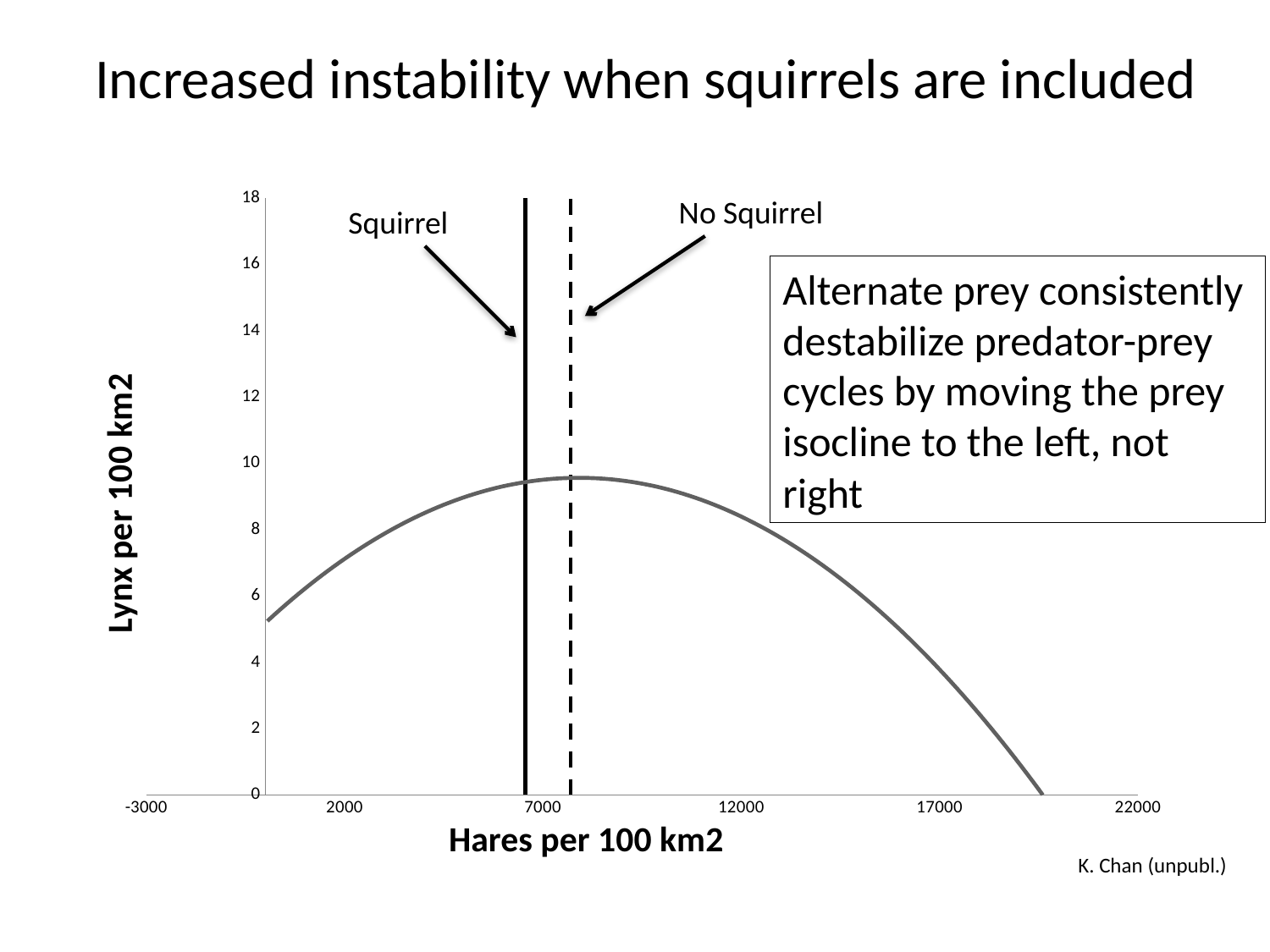
Is the peak value of the curve greater or less than 8 lynx per 100 km2? greater What is the label of the y axis of the chart? Lynx per 100 km2 Is the hare density at which the curve reaches 0 greater or less than 17000? greater What kind of chart is shown on the slide? line chart Is the peak value of the curve greater or less than 10 lynx per 100 km2? less Which vertical line is positioned further to the left on the chart, Squirrel or No Squirrel? Squirrel Does the curve rise or fall between 12000 and 17000 hares per 100 km2? falls What is the label of the x axis of the chart? Hares per 100 km2 How does the curve behave as hare density increases from 2000 to 22000? rises then falls